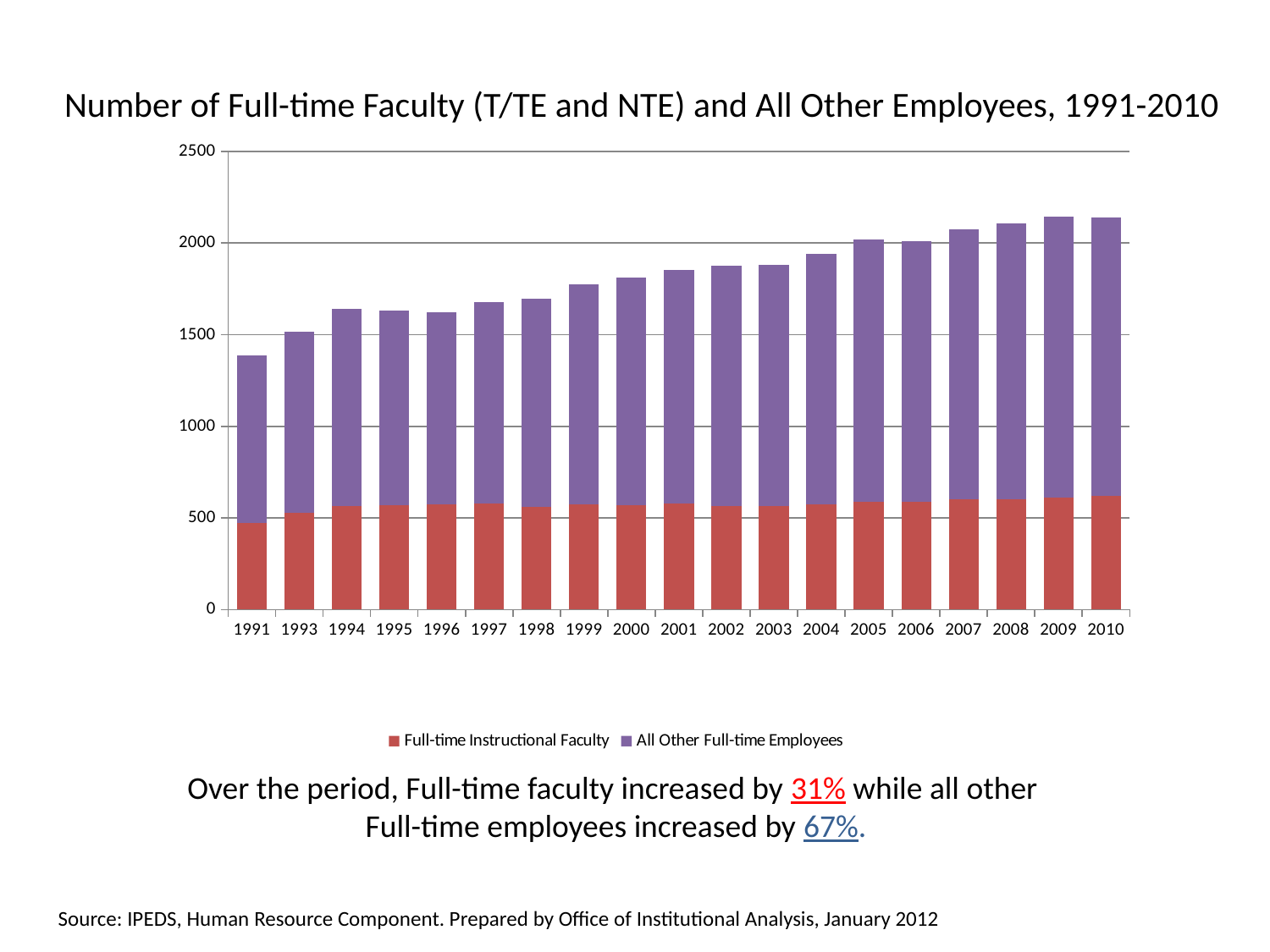
Is the total bar height for 2004 greater or less than 2000? less Which series is shown in red? Full-time Instructional Faculty Which year has the larger total bar, 1991 or 2010? 2010 Is the total bar height for 2010 greater or less than 2000? greater Is the value for Full-time Instructional Faculty in 2010 greater or less than 500? greater What kind of chart is shown on the slide? Stacked bar chart Which year has the lowest total number of full-time employees? 1991 How many series does the legend list? 2 How many years are shown along the x axis? 19 Do the total bar heights generally rise or fall from 1991 to 2010? Rise